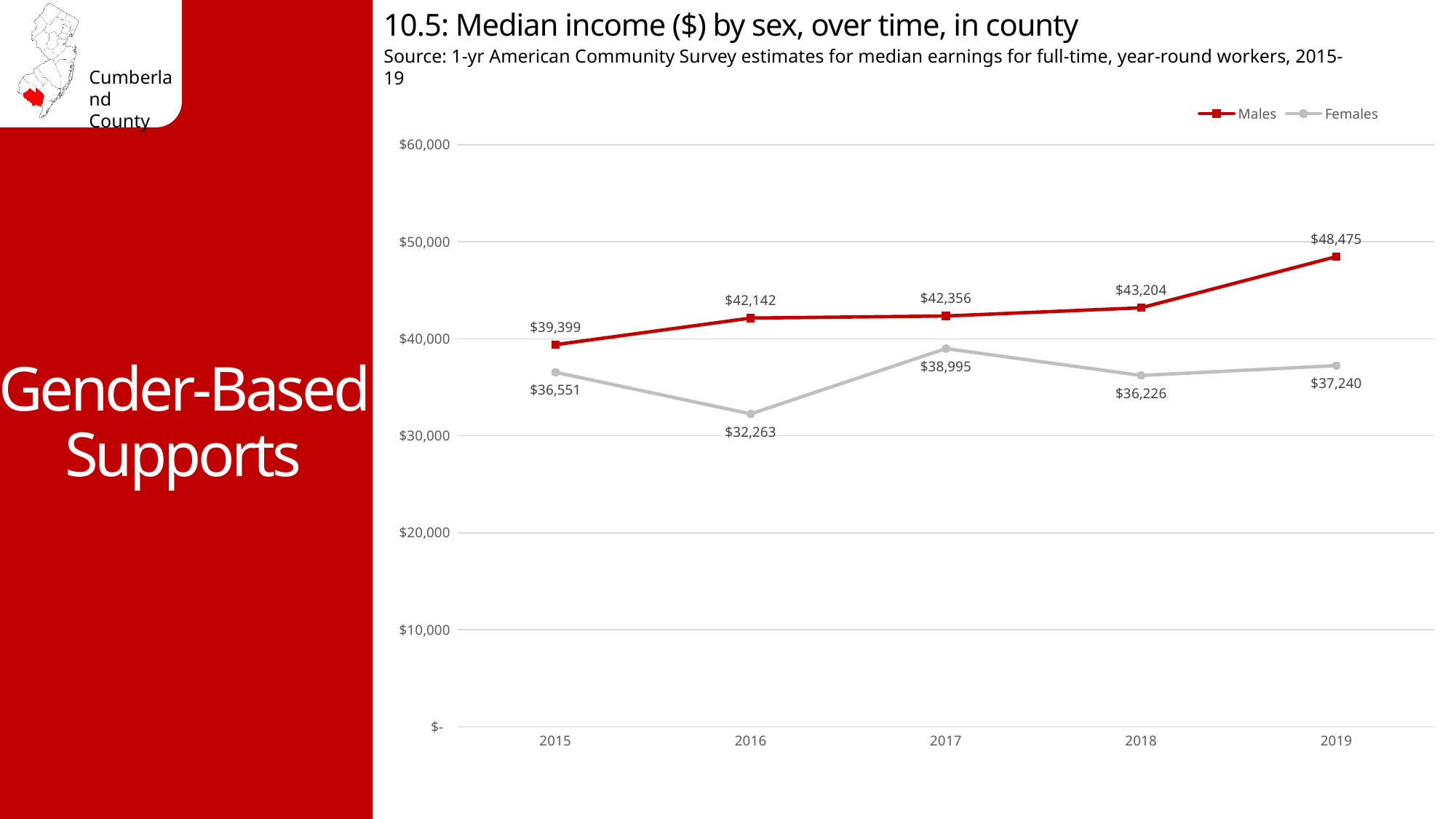
What was the median income for Females in 2016? $32,263 In which year was the median income for Males highest? 2019 What was the median income for Males in 2015? $39,399 What is the difference between the Males and Females median income in 2019? $11,235 In which year was the median income for Females lowest? 2016 Does the median income for Males rise or fall from 2015 to 2019? Rise Which series had the higher median income in 2018, Males or Females? Males What kind of chart is shown on the slide? Line chart What was the median income for Females in 2017? $38,995 How many series does the legend list? 2 How many years are shown on the x axis? 5 What was the median income for Males in 2019? $48,475